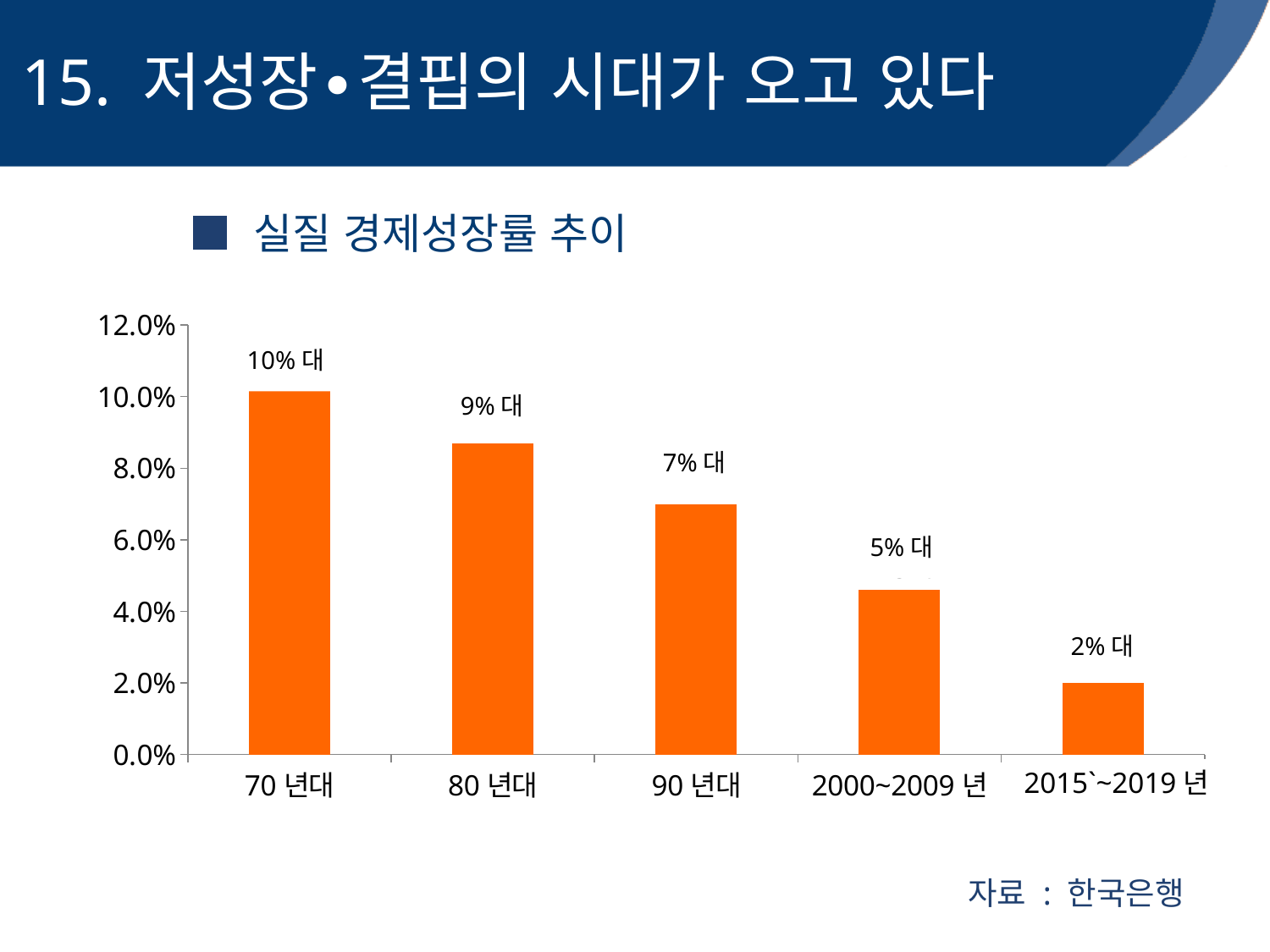
What is the data label shown for 80 년대? 9% 대 Which category has the lowest bar? 2015`~2019 년 What is the data label shown for 2000~2009 년? 5% 대 Which category has the highest bar? 70 년대 What is the data label shown for 70 년대? 10% 대 Is the value for 2000~2009 년 greater or less than 6.0%? less Do the values rise or fall from left to right along the x axis? Fall What is the data label shown for 90 년대? 7% 대 How many categories are shown on the x axis? 5 What kind of chart is shown on the slide? Bar chart Which is larger, the value for 80 년대 or the value for 2000~2009 년? 80 년대 What is the data label shown for 2015`~2019 년? 2% 대